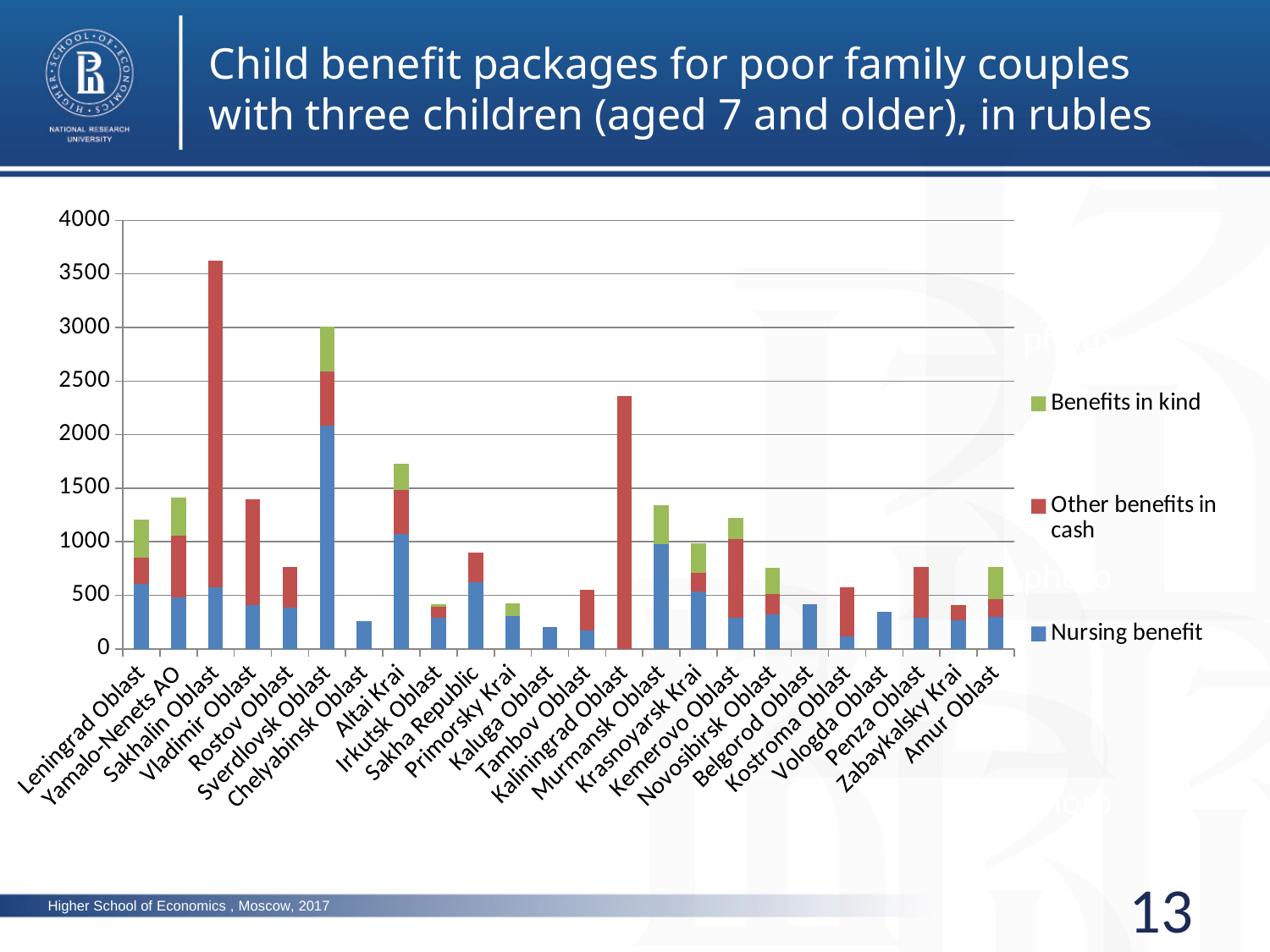
Is the total value for Kaliningrad Oblast greater or less than 2000? greater Which has a larger total benefit package, Sakhalin Oblast or Sverdlovsk Oblast? Sakhalin Oblast Which region has the largest Nursing benefit segment? Sverdlovsk Oblast What kind of chart is shown on the slide? Stacked bar chart Which series is shown in green in the legend? Benefits in kind Is the total value for Murmansk Oblast greater or less than 1000? greater Is the total value for Sakhalin Oblast greater or less than 3000? greater Which region has the highest total child benefit package? Sakhalin Oblast How many series does the legend list? 3 Which region has the lowest total child benefit package? Kaluga Oblast How many regions are shown on the x axis of the chart? 24